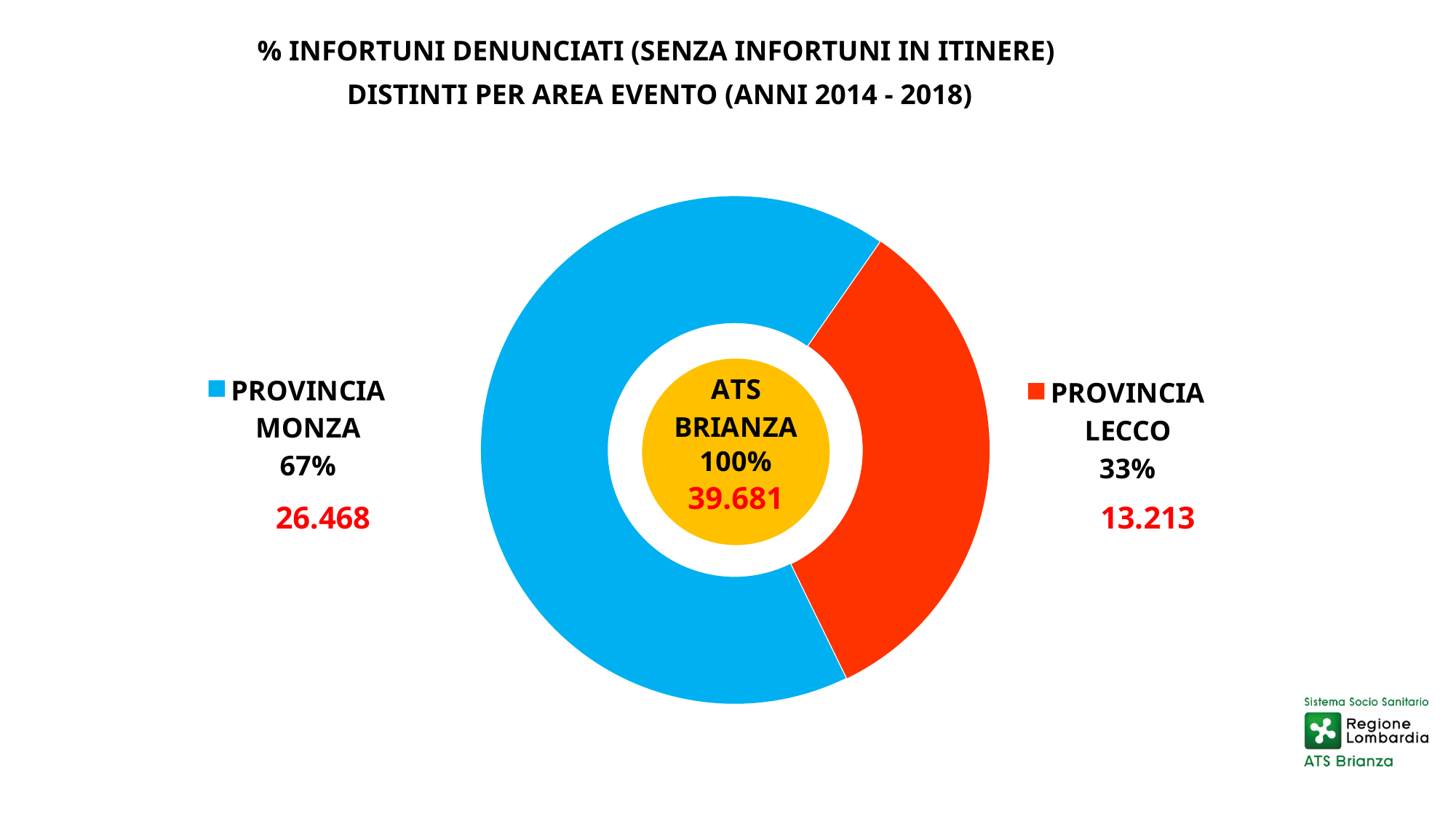
What is the number of reported injuries for PROVINCIA MONZA? 26.468 What percentage share does PROVINCIA LECCO have? 33% How many categories (slices) does the chart show? 2 What is the total number shown for ATS BRIANZA? 39.681 What is the number of reported injuries for PROVINCIA LECCO? 13.213 Which province has the larger share of reported injuries? PROVINCIA MONZA What is the difference in percentage points between PROVINCIA MONZA and PROVINCIA LECCO? 34 Which province has the smaller share of reported injuries? PROVINCIA LECCO What years does the chart title say the data covers? 2014 - 2018 What kind of chart is shown on the slide? Pie chart (doughnut) Which colour represents PROVINCIA LECCO? Red What percentage share does PROVINCIA MONZA have? 67%